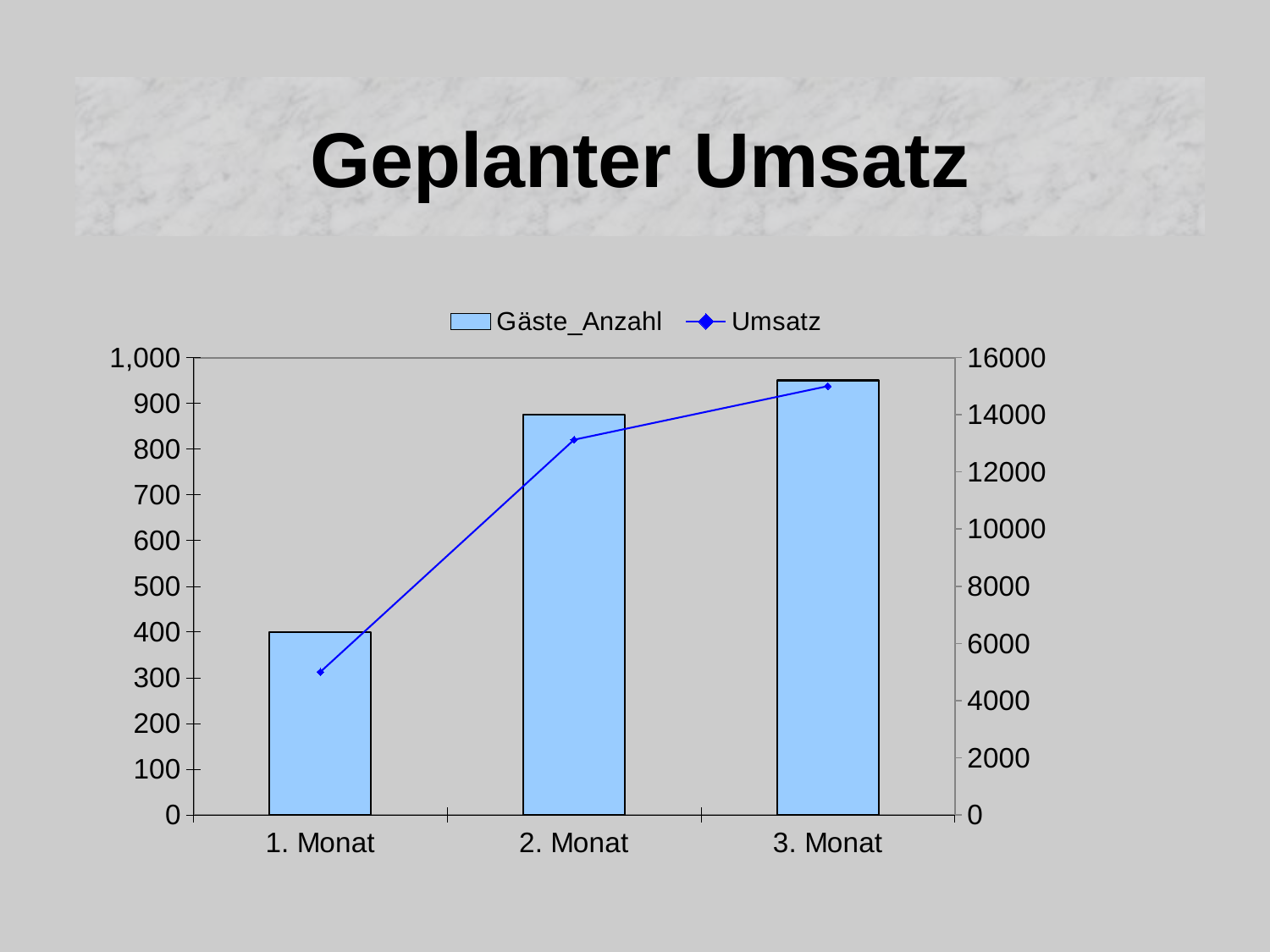
Which is larger, the Gäste_Anzahl for 1. Monat or for 2. Monat? 2. Monat What kind of chart is shown? Combined bar and line chart Is the Gäste_Anzahl value for 2. Monat greater or less than 800? greater What is the title of the chart on the slide? Geplanter Umsatz Which month has the highest Gäste_Anzahl bar? 3. Monat How many months are shown on the x axis? 3 Is the Umsatz value for 1. Monat greater or less than 6000? less Is the Umsatz value for 2. Monat greater or less than 12000? greater Which month has the lowest Gäste_Anzahl bar? 1. Monat How many series does the legend list? 2 Does the Umsatz line rise or fall from 1. Monat to 3. Monat? rise Which series is drawn as a line with diamond markers? Umsatz